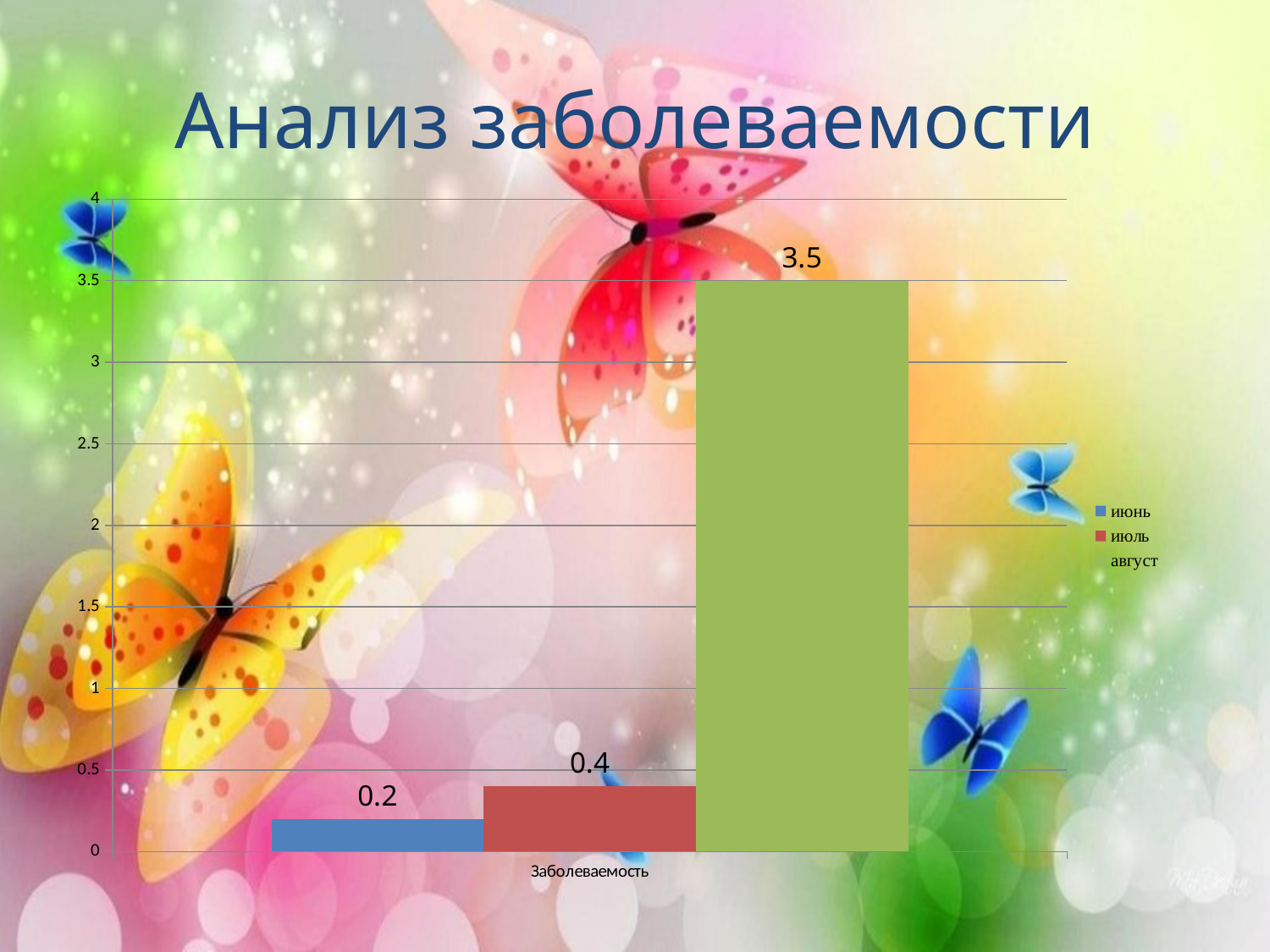
What kind of chart is shown on the slide? bar chart Which is larger, the value for июль or the value for июнь? июль Which month has the highest value in the chart? август Which month has the lowest value in the chart? июнь What is the value for июнь (June) in the chart? 0.2 What is the difference between the values for июль and июнь? 0.2 What is the title of the slide containing the chart? Анализ заболеваемости What is the value for июль (July) in the chart? 0.4 Is the value for август greater or less than 3? greater How many series does the legend list? 3 What is the difference between the values for август and июль? 3.1 What is the value for август (August) in the chart? 3.5